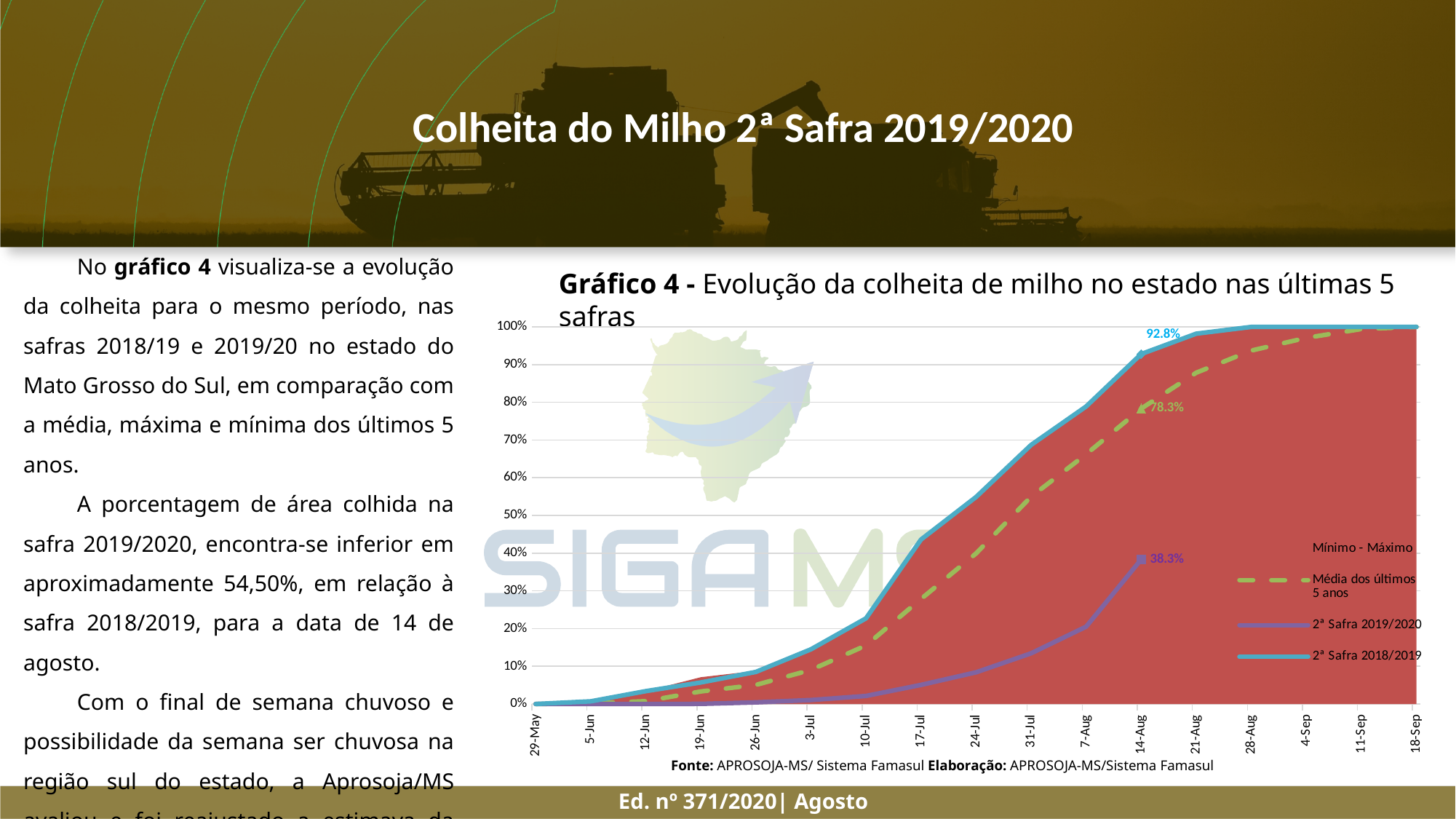
What value is labelled for the Média dos últimos 5 anos series at 14-Aug? 78.3% Does the 2ª Safra 2018/2019 series rise or fall from 29-May to 18-Sep? rise What is the title of the chart? Gráfico 4 - Evolução da colheita de milho no estado nas últimas 5 safras How many date labels are shown on the x axis? 17 Is the value for 2ª Safra 2018/2019 at 10-Jul greater or less than 10%? greater At 14-Aug, which series has the larger labelled value: 2ª Safra 2018/2019 or 2ª Safra 2019/2020? 2ª Safra 2018/2019 How many series does the legend list? 4 What value is labelled for the 2ª Safra 2018/2019 series at 14-Aug? 92.8% What is the difference between the labelled 14-Aug values of 2ª Safra 2018/2019 and 2ª Safra 2019/2020? 54.5 percentage points What is the difference between the labelled 14-Aug values of Média dos últimos 5 anos and 2ª Safra 2019/2020? 40.0 percentage points Is the value for 2ª Safra 2019/2020 at 7-Aug greater or less than 30%? less What value is labelled for the 2ª Safra 2019/2020 series at 14-Aug? 38.3%